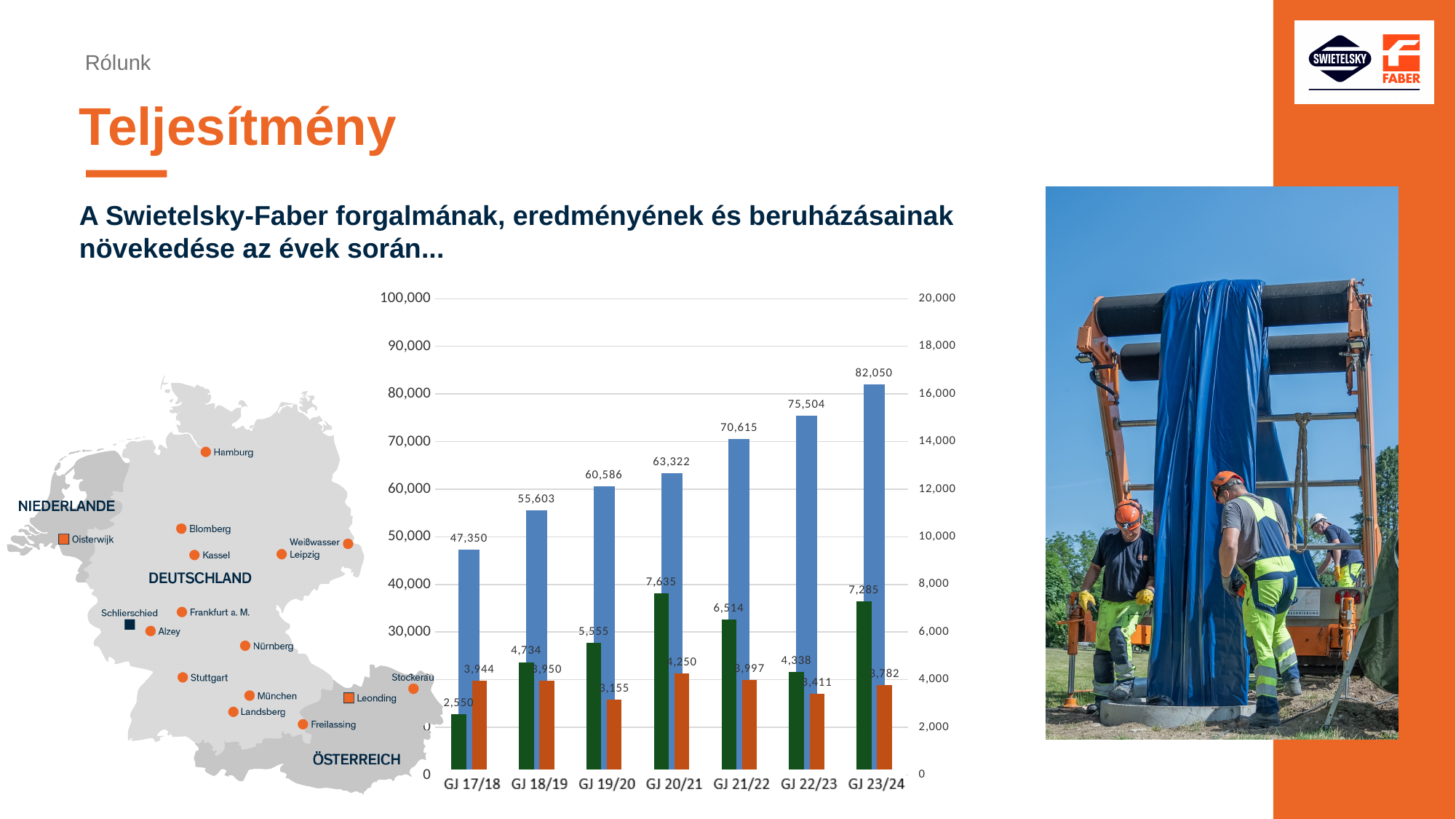
What is the value of the blue bar for GJ 23/24? 82,050 What is the maximum value shown on the left vertical axis of the chart? 100,000 Do the blue bar values rise or fall from GJ 17/18 to GJ 23/24? rise What is the value of the blue bar for GJ 17/18? 47,350 In which year is the blue bar highest? GJ 23/24 Which is larger, the green bar for GJ 21/22 or the green bar for GJ 22/23? GJ 21/22 What type of chart is shown on the slide? bar chart What is the value of the green bar for GJ 20/21? 7,635 What is the value of the orange bar for GJ 19/20? 3,155 In which year is the green bar lowest? GJ 17/18 How many fiscal-year categories are shown on the x axis of the chart? 7 What is the difference between the blue bar values for GJ 23/24 and GJ 22/23? 6,546